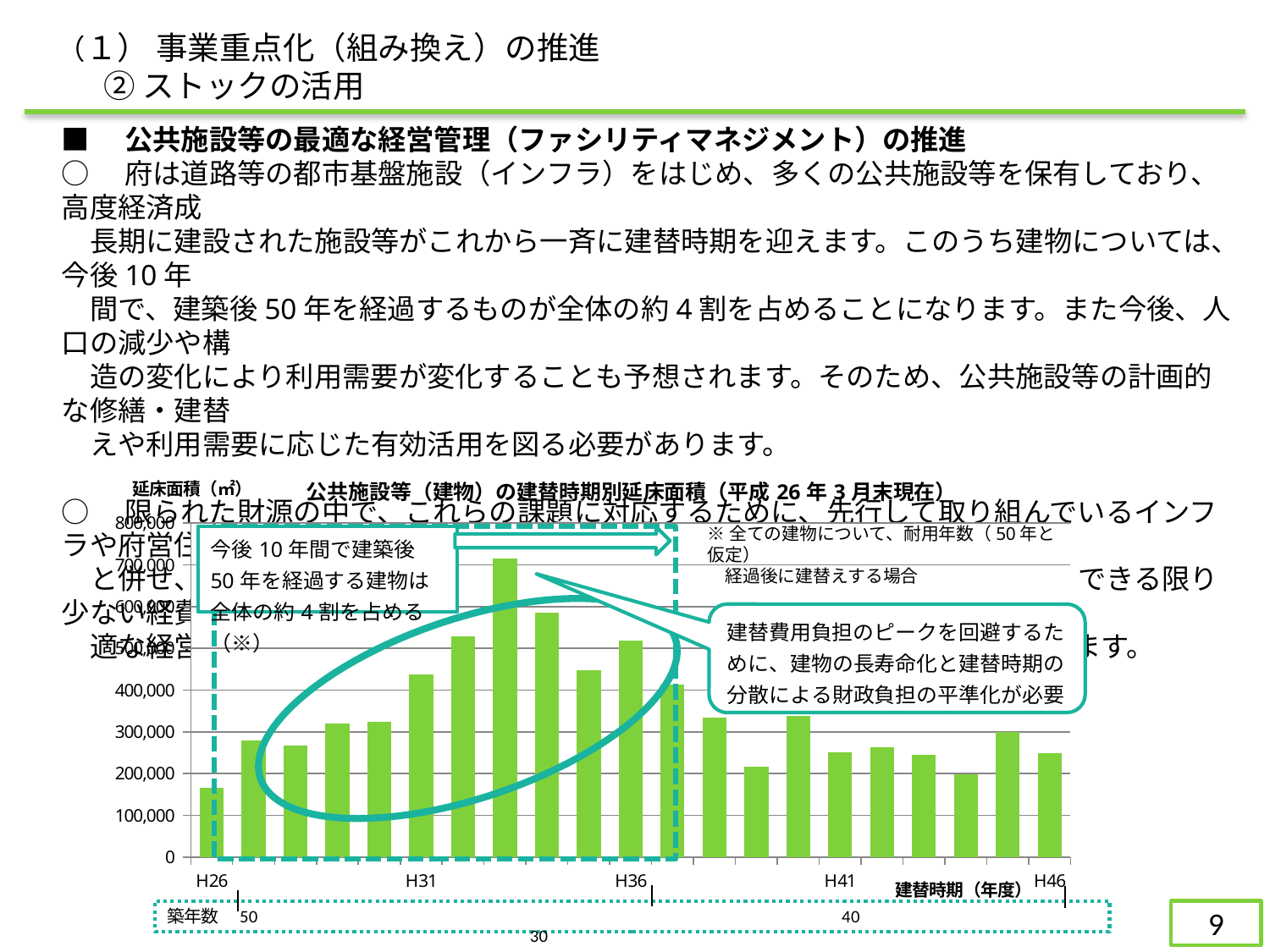
What type of chart is shown on the slide? bar chart What is the title of the chart? 公共施設等（建物）の建替時期別延床面積（平成26年3月末現在） Which has the larger value, H26 or H41? H41 How many bars are plotted in the chart? 21 Do the values rise or fall from H26 to H31? rise Is the value for H26 greater or less than 200,000? less What is the label of the vertical axis of the chart? 延床面積（㎡） Is the value for H31 greater or less than 400,000? greater Is the value for H41 greater or less than 300,000? less Which has the larger value, H31 or H36? H36